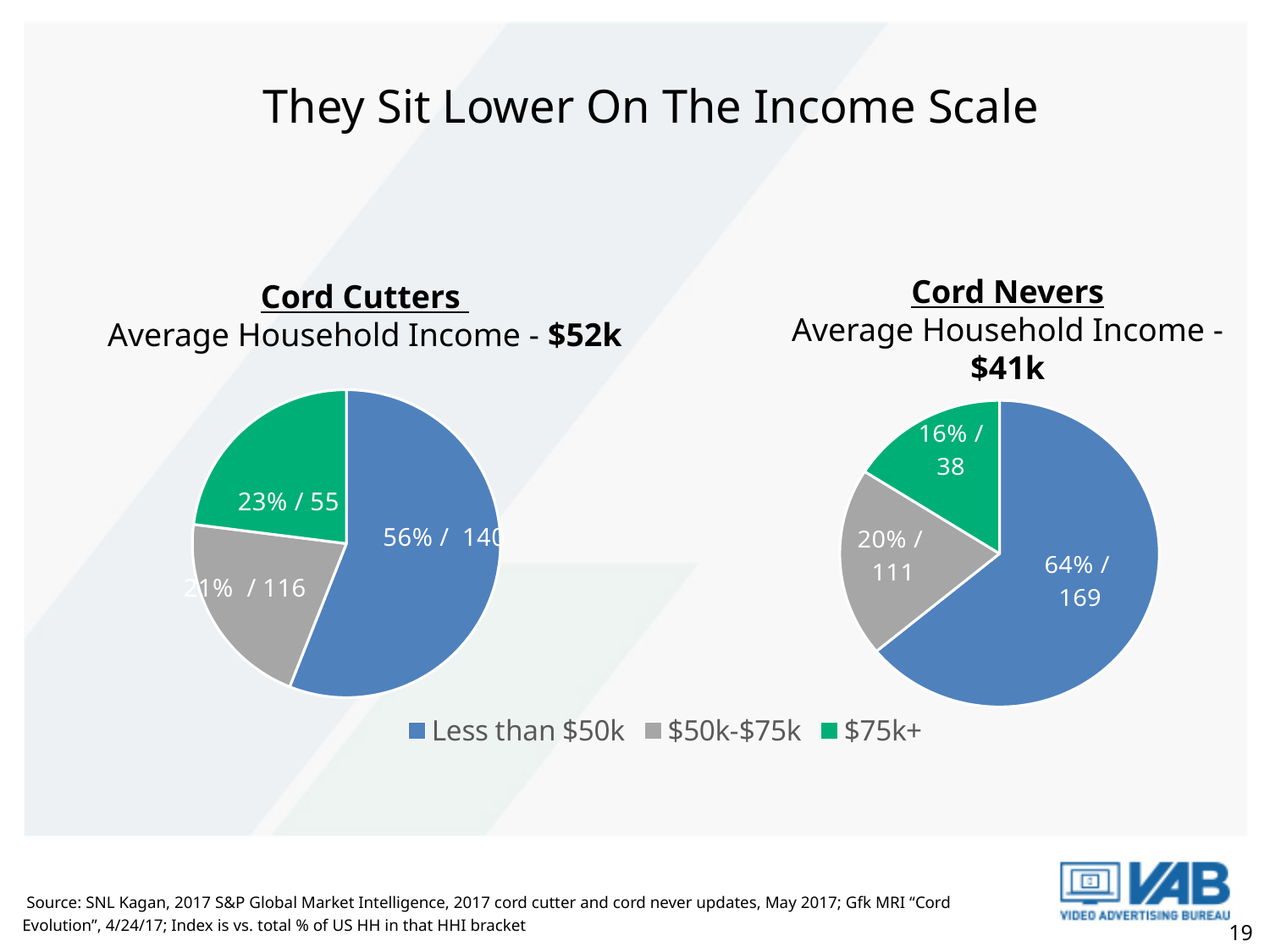
In the Cord Nevers pie chart, what share of households earn less than $50k? 64% What is the difference in percentage points between the Cord Nevers and Cord Cutters shares for the less than $50k bracket? 8 percentage points In the Cord Nevers pie chart, which income bracket has the largest share? Less than $50k What kind of charts are shown on the slide? Pie charts In the Cord Nevers pie chart, which income bracket has the smallest share? $75k+ In the Cord Nevers pie chart, what share of households earn $75k+? 16% Which group has a larger share of households earning less than $50k, Cord Cutters or Cord Nevers? Cord Nevers How many income brackets does the legend list? 3 In the Cord Cutters pie chart, what share of households earn $75k+? 23% In the Cord Nevers pie chart, what is the index value for the $50k-$75k bracket? 111 In the Cord Cutters pie chart, what is the index value for the $75k+ bracket? 55